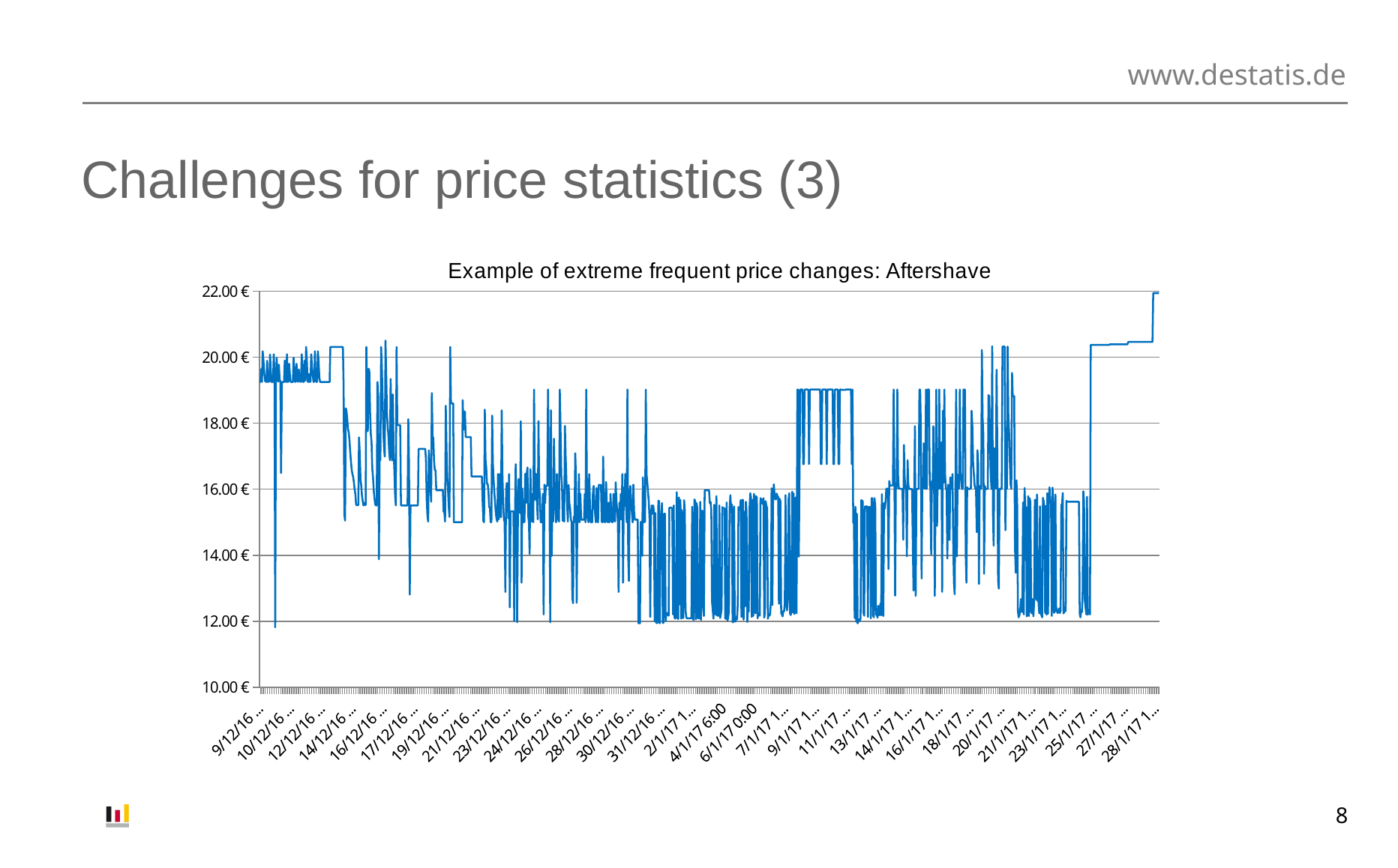
Does the price rise or fall over the final segment of the series, from about 25/1/17 to 28/1/17? rise Is the price at the start of the series (9/12/16) greater or less than 18.00 €? greater What kind of chart is shown on the slide? line chart Is the lowest price reached in the series greater or less than 14.00 €? less In what currency are the prices on the vertical axis shown? € Is the price around 27/1/17 greater or less than 18.00 €? greater How many value labels are shown on the vertical axis of the chart? 7 What is the highest value labelled on the vertical axis of the chart? 22.00 € What is the title of the chart? Example of extreme frequent price changes: Aftershave What is the lowest value labelled on the vertical axis of the chart? 10.00 €